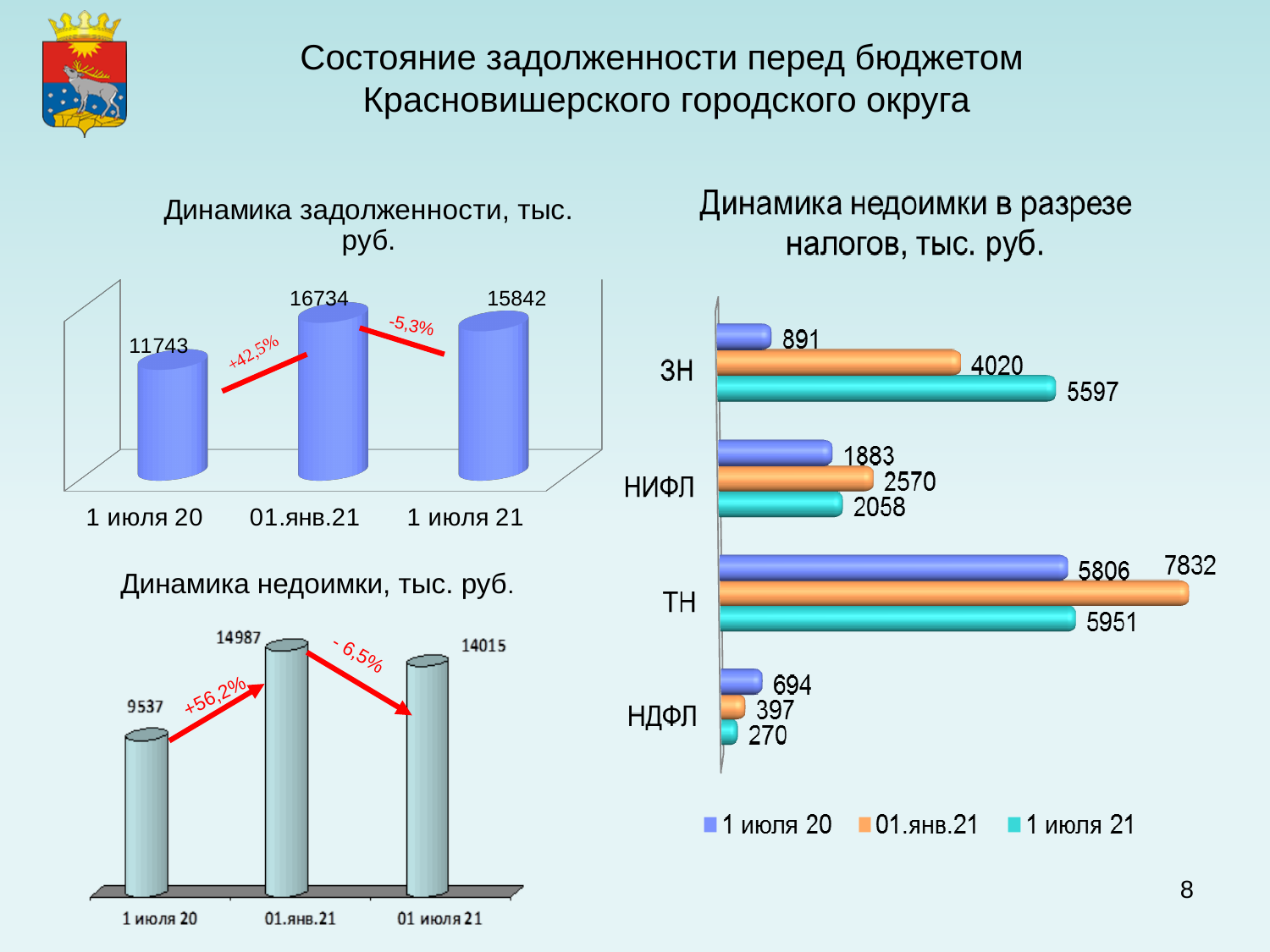
In the chart 'Динамика недоимки в разрезе налогов, тыс. руб.', which is larger for ЗН: the value on 1 июля 20 or on 1 июля 21? 1 июля 21 In the chart 'Динамика недоимки, тыс. руб.', what is the value for 1 июля 20? 9537 In the chart 'Динамика недоимки в разрезе налогов, тыс. руб.', what is the difference between the 01.янв.21 and 1 июля 21 values for НИФЛ? 512 In the chart 'Динамика недоимки в разрезе налогов, тыс. руб.', what is the value for ТН on 01.янв.21? 7832 In the chart 'Динамика недоимки, тыс. руб.', how many bars are plotted? 3 In the chart 'Динамика недоимки в разрезе налогов, тыс. руб.', what is the value for НДФЛ on 1 июля 21? 270 What kind of chart is 'Динамика недоимки в разрезе налогов, тыс. руб.'? bar chart In the chart 'Динамика недоимки в разрезе налогов, тыс. руб.', how many series does the legend list? 3 In the chart 'Динамика задолженности, тыс. руб.', what is the value for 01.янв.21? 16734 In the chart 'Динамика недоимки, тыс. руб.', which date has the highest value? 01.янв.21 In the chart 'Динамика задолженности, тыс. руб.', which date has the lowest value? 1 июля 20 In the chart 'Динамика задолженности, тыс. руб.', what is the difference between the values for 01.янв.21 and 1 июля 21? 892